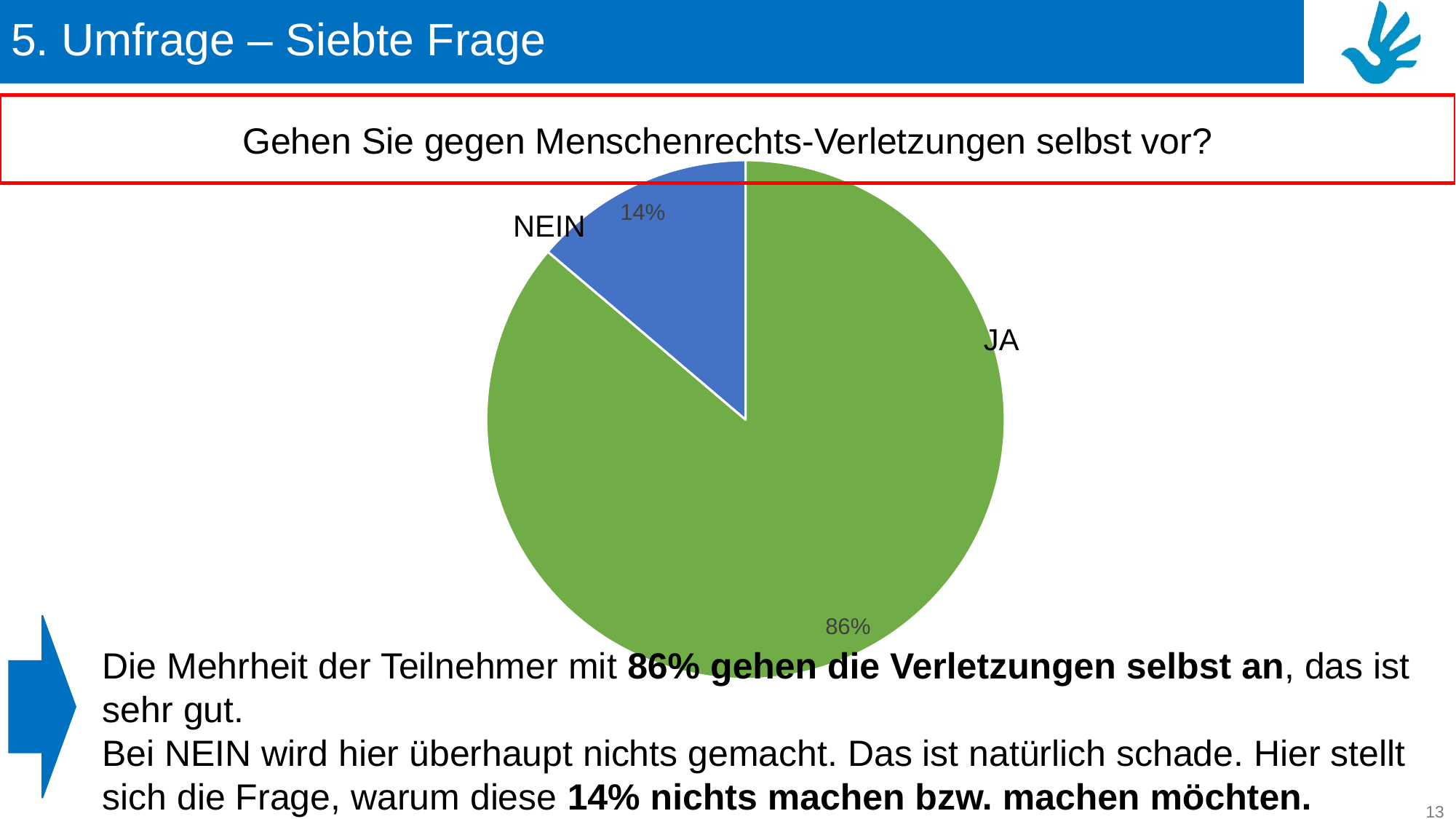
Which slice is larger, JA or NEIN? JA What colour is the JA slice of the pie chart? green What kind of chart is shown on the slide? pie chart What percentage of the pie chart is labelled NEIN? 14% What is the difference in percentage points between the JA and NEIN slices? 72 What colour is the NEIN slice of the pie chart? blue Which slice of the pie chart is the smallest? NEIN What percentage of the pie chart is labelled JA? 86% What share of the pie does the NEIN slice represent? 14% Which slice of the pie chart is the largest? JA How many slices does the pie chart have? 2